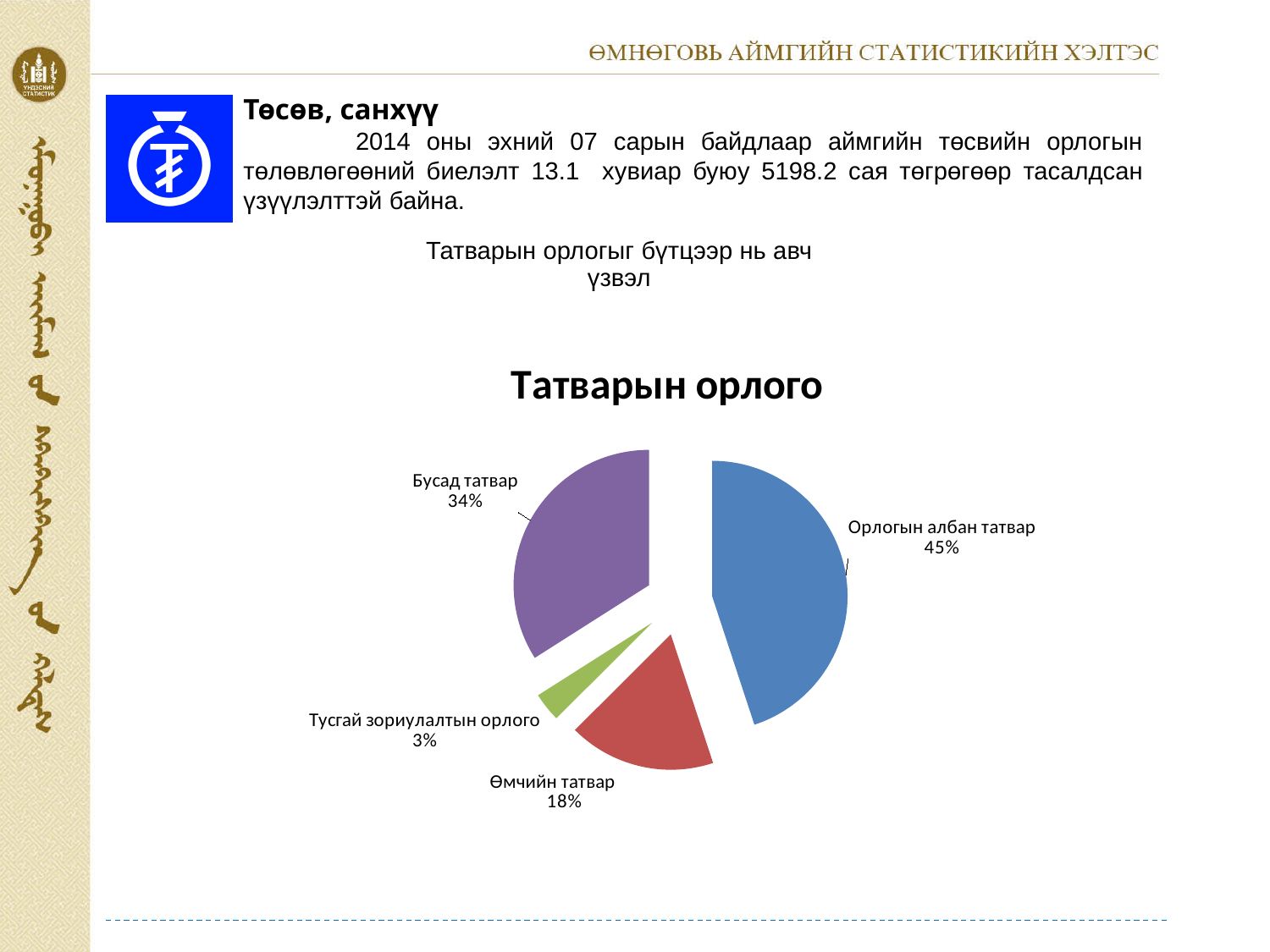
What is the share of Орлогын албан татвар in the Татварын орлого pie chart? 45% What is the share of Өмчийн татвар in the pie chart? 18% Which category has the smallest share in the pie chart? Тусгай зориулалтын орлого Which category has the largest share in the Татварын орлого pie chart? Орлогын албан татвар Which is larger, the share of Бусад татвар or the share of Өмчийн татвар? Бусад татвар What is the difference in percentage points between Өмчийн татвар and Тусгай зориулалтын орлого? 15 percentage points What is the title of the chart? Татварын орлого What is the difference in percentage points between Орлогын албан татвар and Бусад татвар? 11 percentage points How many categories are shown in the pie chart? 4 What is the share of Бусад татвар in the pie chart? 34% What kind of chart is shown on the slide? Pie chart